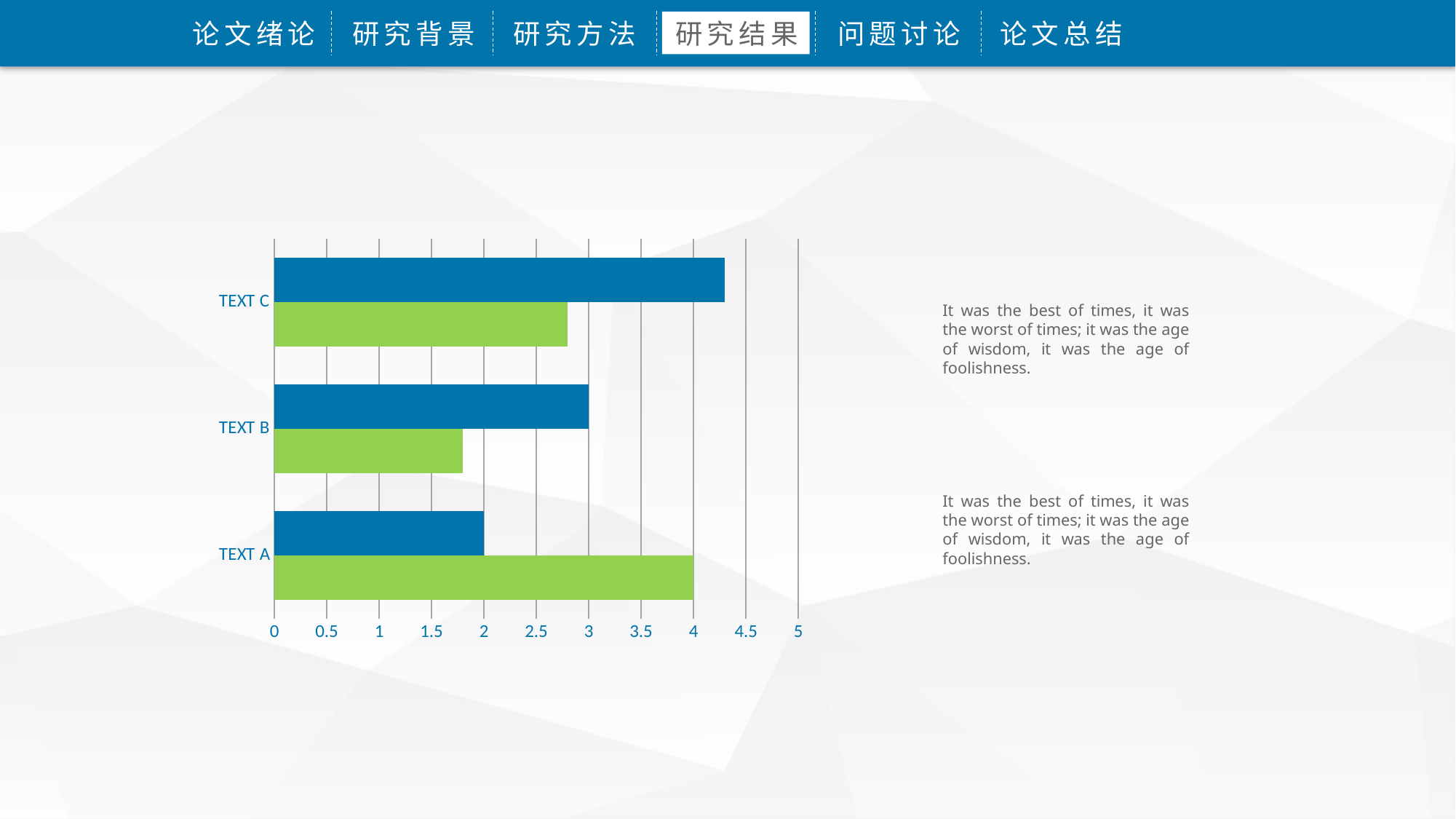
What is the value of the green bar for TEXT A? 4 How many categories are shown on the chart? 3 Is the value of the green bar for TEXT C greater or less than 3? less What kind of chart is shown on the slide? bar chart Is the value of the green bar for TEXT B greater or less than 2? less Which category has the longest blue bar? TEXT C Which category has the shortest green bar? TEXT B What is the value of the blue bar for TEXT B? 3 For TEXT A, which bar is larger, the blue one or the green one? green Is the value of the blue bar for TEXT C greater or less than 4? greater What is the value of the blue bar for TEXT A? 2 What is the difference between the green bar and the blue bar for TEXT A? 2